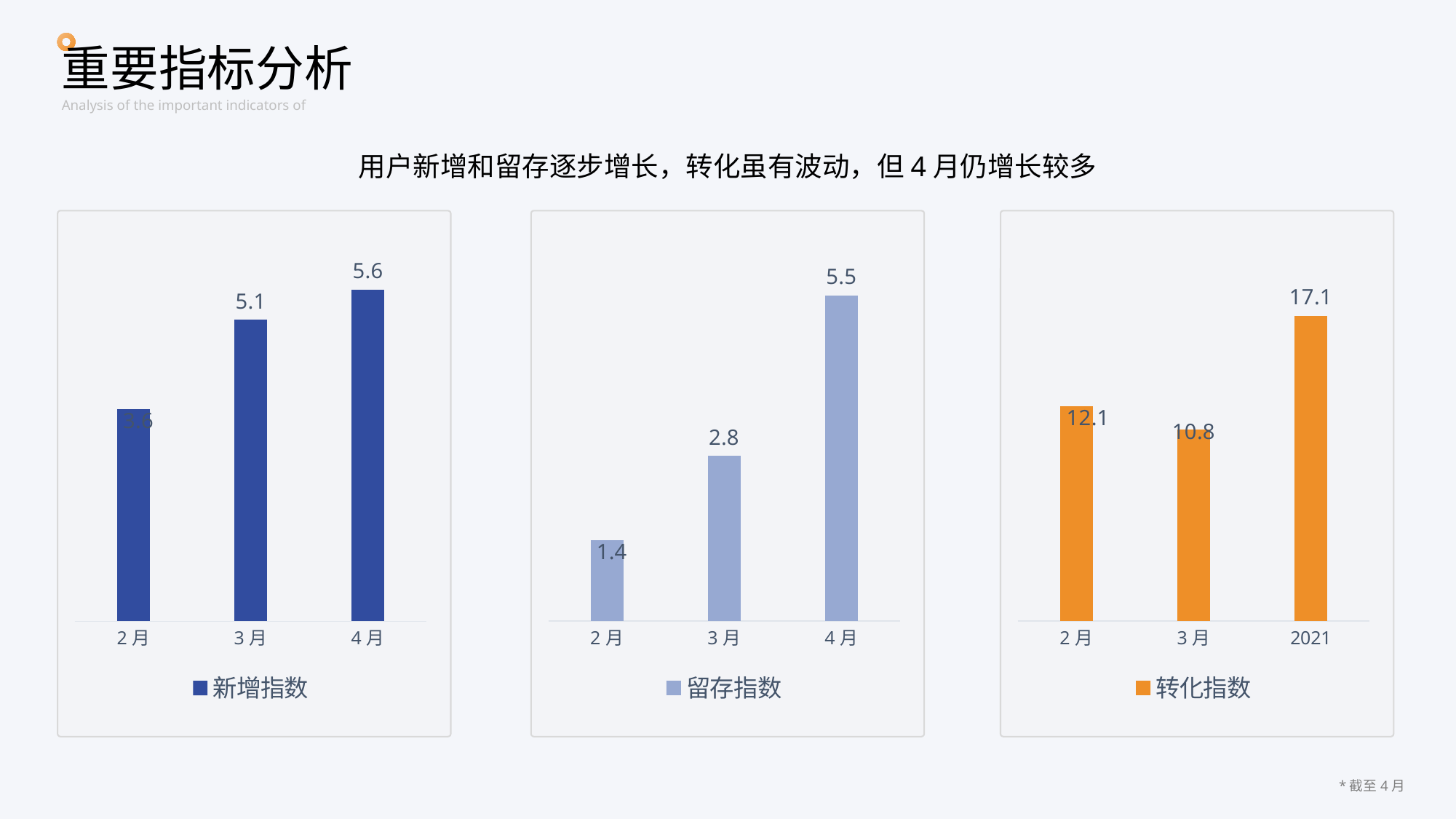
In the left chart (新增指数), what is the value for 3月? 5.1 In the right chart (转化指数), what is the value for 3月? 10.8 In the middle chart (留存指数), do the values rise or fall from 2月 to 4月? rise How many bars are in the left chart (新增指数)? 3 In the middle chart (留存指数), what is the value for 2月? 1.4 In the middle chart (留存指数), what is the difference between the values for 4月 and 3月? 2.7 In the left chart (新增指数), what is the value for 4月? 5.6 In the right chart (转化指数), what is the difference between the values for 2021 and 2月? 5.0 In the middle chart (留存指数), which category has the highest value? 4月 In the right chart (转化指数), which is larger, the value for 2月 or the value for 3月? 2月 In the right chart (转化指数), which category has the lowest value? 3月 What type of chart is the right chart (转化指数)? bar chart